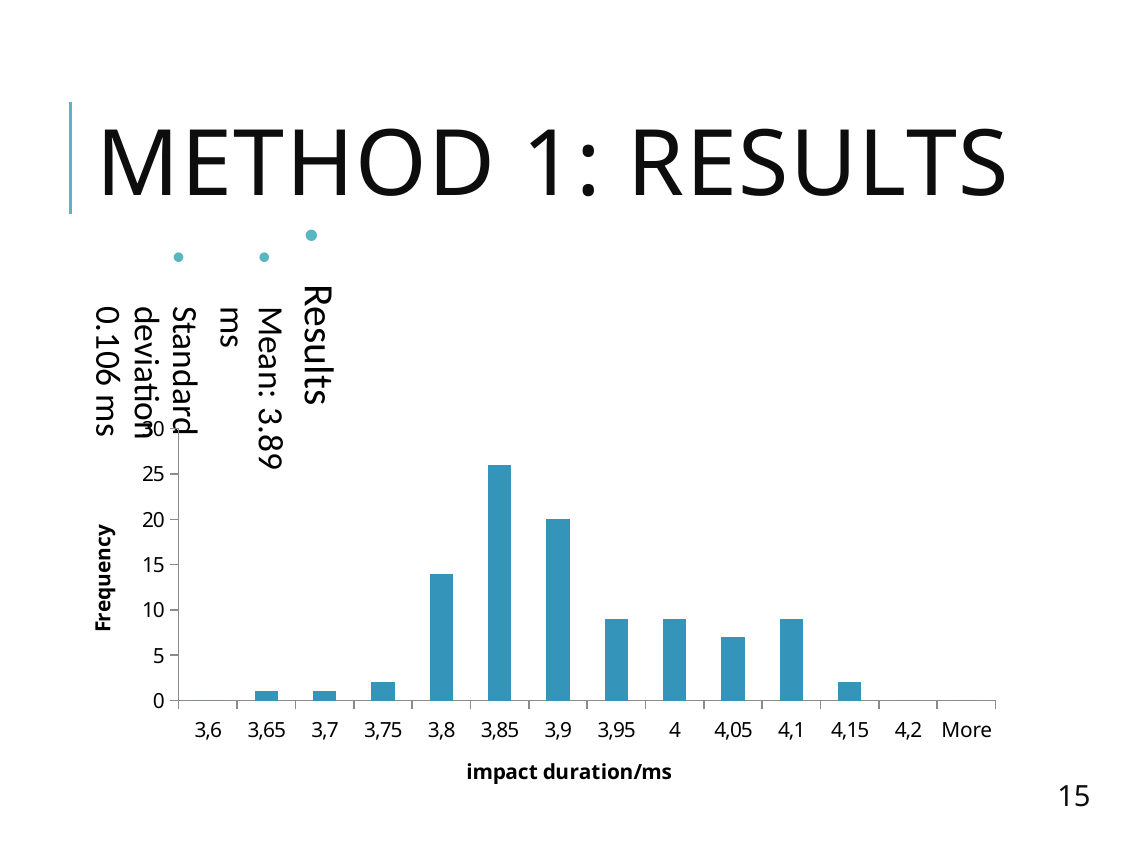
What is the title of the y axis? Frequency Is the frequency for the 4,05 bin greater or less than 10? less Is the frequency for the 3,9 bin greater or less than 15? greater Is the frequency for the 3,75 bin greater or less than 5? less How many bins are labelled along the x axis? 14 What is the title of the x axis? impact duration/ms Which bin has the higher frequency, 3,8 or 4,05? 3,8 What kind of chart is shown on the slide? bar chart Which impact duration bin has the highest frequency? 3,85 Which bin has the higher frequency, 3,85 or 3,9? 3,85